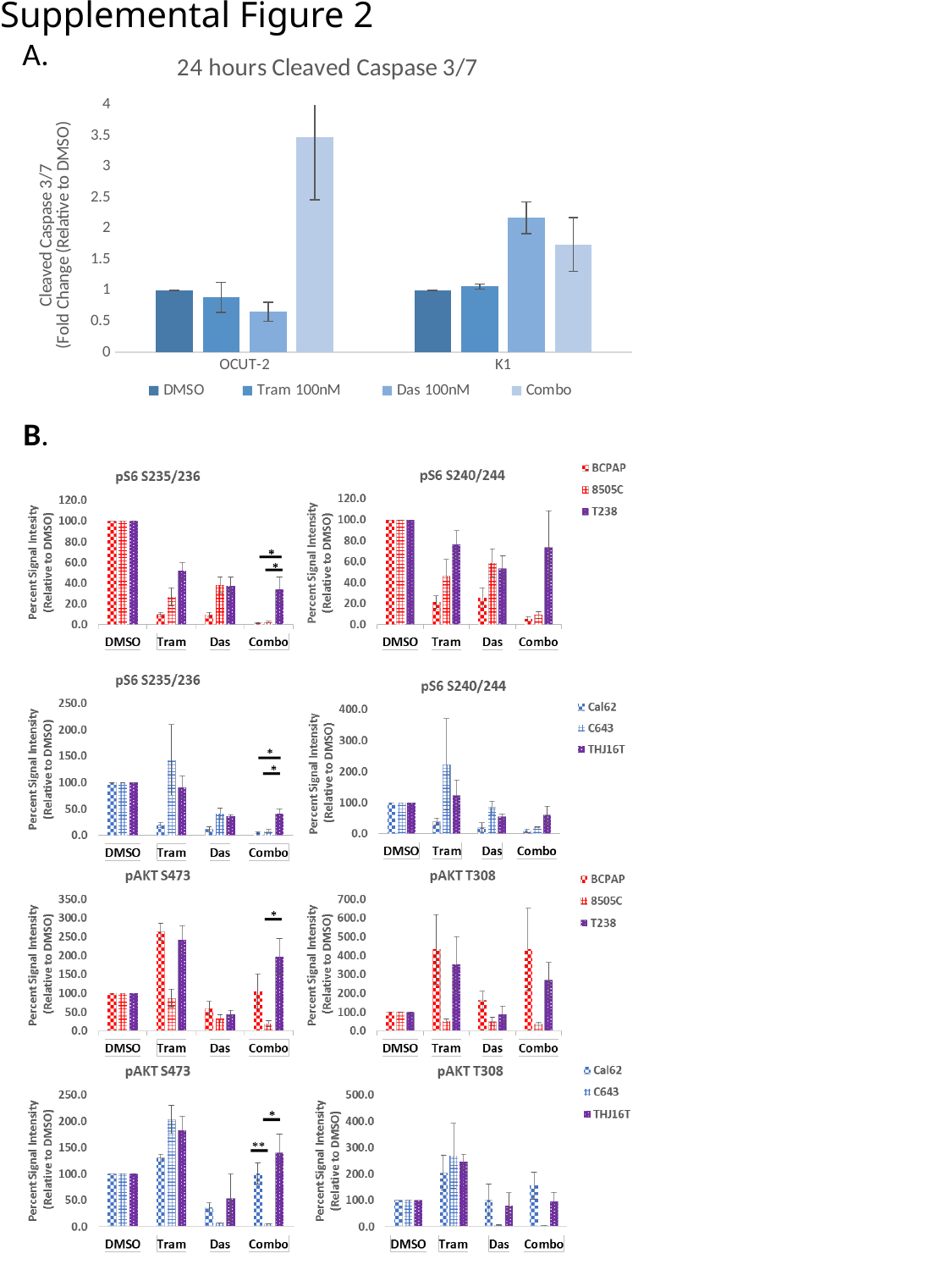
In the chart titled '24 hours Cleaved Caspase 3/7', what kind of chart is shown? bar chart In the chart titled '24 hours Cleaved Caspase 3/7', is the Combo value for OCUT-2 greater or less than 3? greater In the chart titled '24 hours Cleaved Caspase 3/7', how many cell line categories are shown on the x axis? 2 In the chart titled '24 hours Cleaved Caspase 3/7', which treatment has the highest value for OCUT-2? Combo In the chart titled '24 hours Cleaved Caspase 3/7', which treatment has the lowest value for OCUT-2? Das 100nM In the top-left chart of panel B titled 'pS6 S235/236', which cell line has the highest value for Tram? T238 In the chart titled '24 hours Cleaved Caspase 3/7', which is larger for K1: Das 100nM or Combo? Das 100nM In the chart titled '24 hours Cleaved Caspase 3/7', how many series does the legend list? 4 In the panel B chart titled 'pAKT S473' for BCPAP, 8505C and T238, is the BCPAP value for Tram greater or less than 200? greater In the chart titled '24 hours Cleaved Caspase 3/7', is the Das 100nM value for K1 greater or less than 1.5? greater In the chart titled '24 hours Cleaved Caspase 3/7', what is the y-axis title? Cleaved Caspase 3/7 (Fold Change (Relative to DMSO)